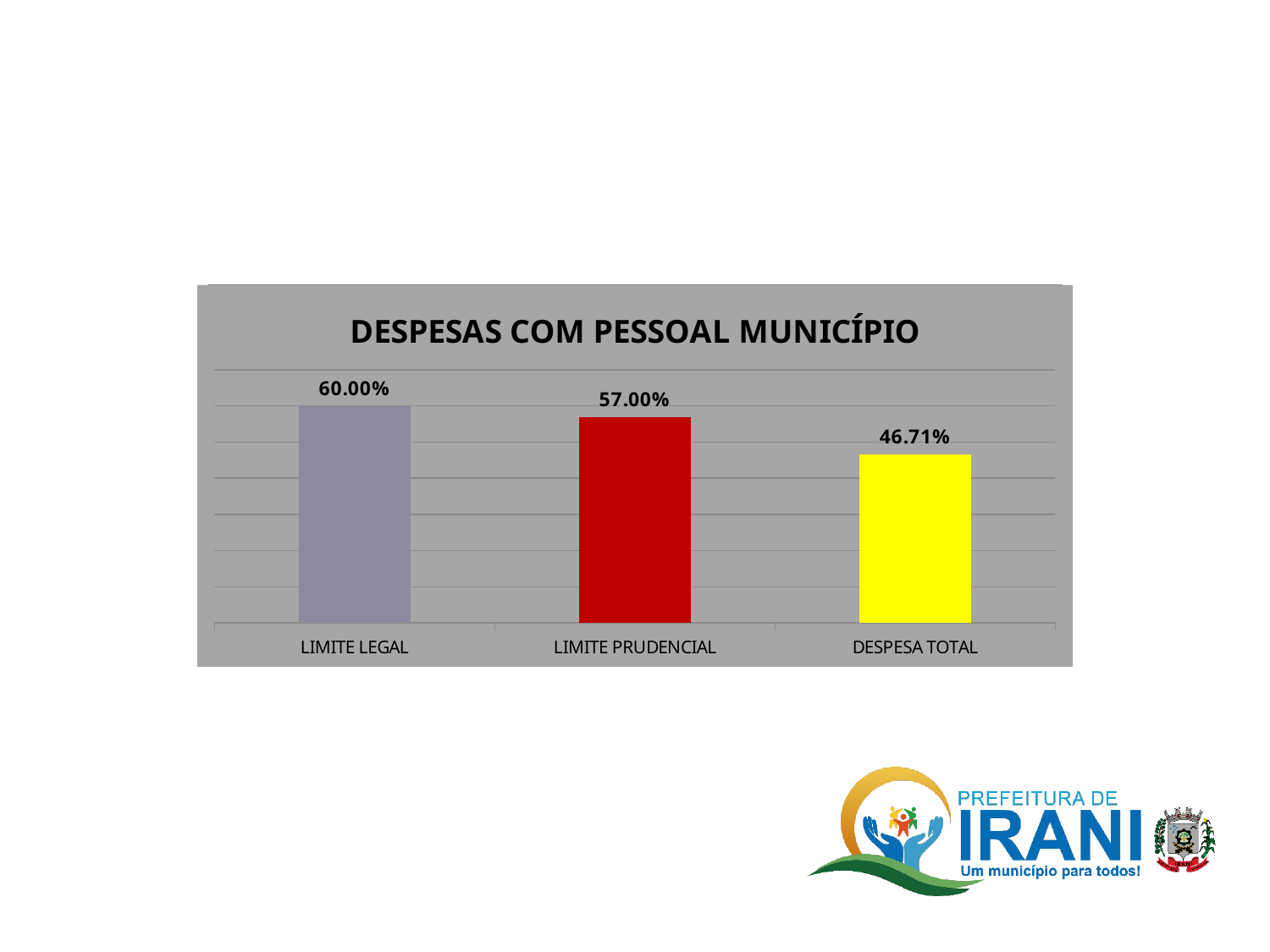
Which category has the lowest value? DESPESA TOTAL How many categories are shown in the chart? 3 What is the value for LIMITE PRUDENCIAL? 57.00% Do the values rise or fall from left to right across the categories? Fall What kind of chart is shown on the slide? Bar chart What is the value for DESPESA TOTAL? 46.71% What is the difference between the values for LIMITE LEGAL and LIMITE PRUDENCIAL? 3.00% Which category has the highest value? LIMITE LEGAL Which is larger, the value for LIMITE PRUDENCIAL or the value for DESPESA TOTAL? LIMITE PRUDENCIAL What is the value for LIMITE LEGAL? 60.00% What is the title of the chart? DESPESAS COM PESSOAL MUNICÍPIO What is the difference between the values for LIMITE PRUDENCIAL and DESPESA TOTAL? 10.29%